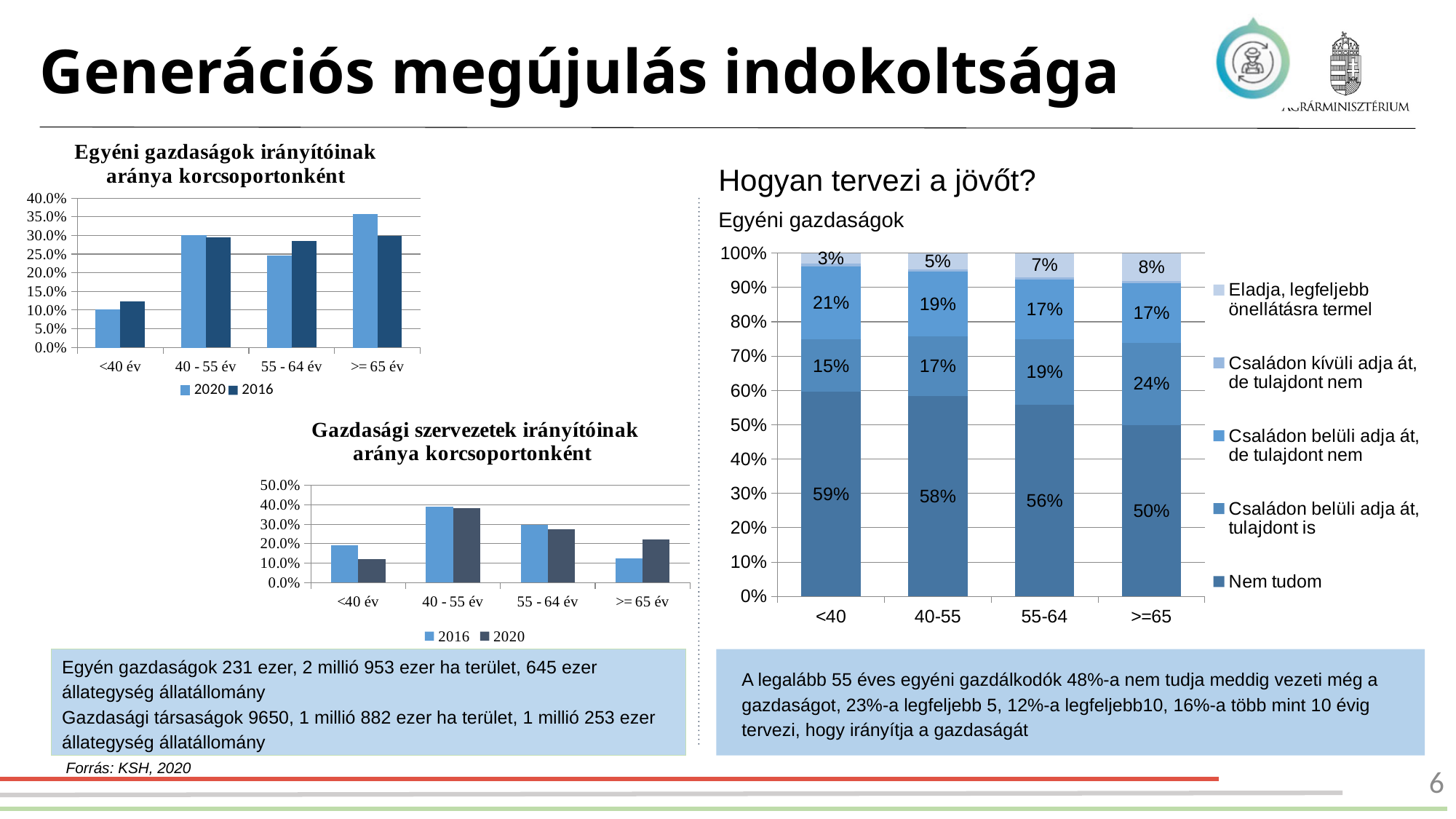
What kind of chart is the 'Hogyan tervezi a jövőt?' chart? Stacked bar chart In the 'Egyéni gazdaságok irányítóinak aránya korcsoportonként' chart, which is larger for >= 65 év, the 2020 value or the 2016 value? 2020 In the 'Hogyan tervezi a jövőt?' chart, which age group has the highest 'Nem tudom' share? <40 In the 'Hogyan tervezi a jövőt?' chart, how many series does the legend list? 5 In the 'Hogyan tervezi a jövőt?' chart, what is the 'Nem tudom' share for the >=65 age group? 50% In the 'Hogyan tervezi a jövőt?' chart, does the 'Nem tudom' share rise or fall as the age group increases? Falls In the 'Gazdasági szervezetek irányítóinak aránya korcsoportonként' chart, which age group has the highest 2016 value? 40 - 55 év In the 'Gazdasági szervezetek irányítóinak aránya korcsoportonként' chart, how many age-group categories are shown on the x axis? 4 In the 'Hogyan tervezi a jövőt?' chart, what is the 'Eladja, legfeljebb önellátásra termel' share for the 55-64 age group? 7% In the 'Hogyan tervezi a jövőt?' chart, what is the difference in percentage points between the 'Nem tudom' share for <40 and for >=65? 9 percentage points In the 'Egyéni gazdaságok irányítóinak aránya korcsoportonként' chart, is the 2016 value for <40 év greater or less than 15.0%? less In the 'Hogyan tervezi a jövőt?' chart, what is the 'Nem tudom' share for the <40 age group? 59%